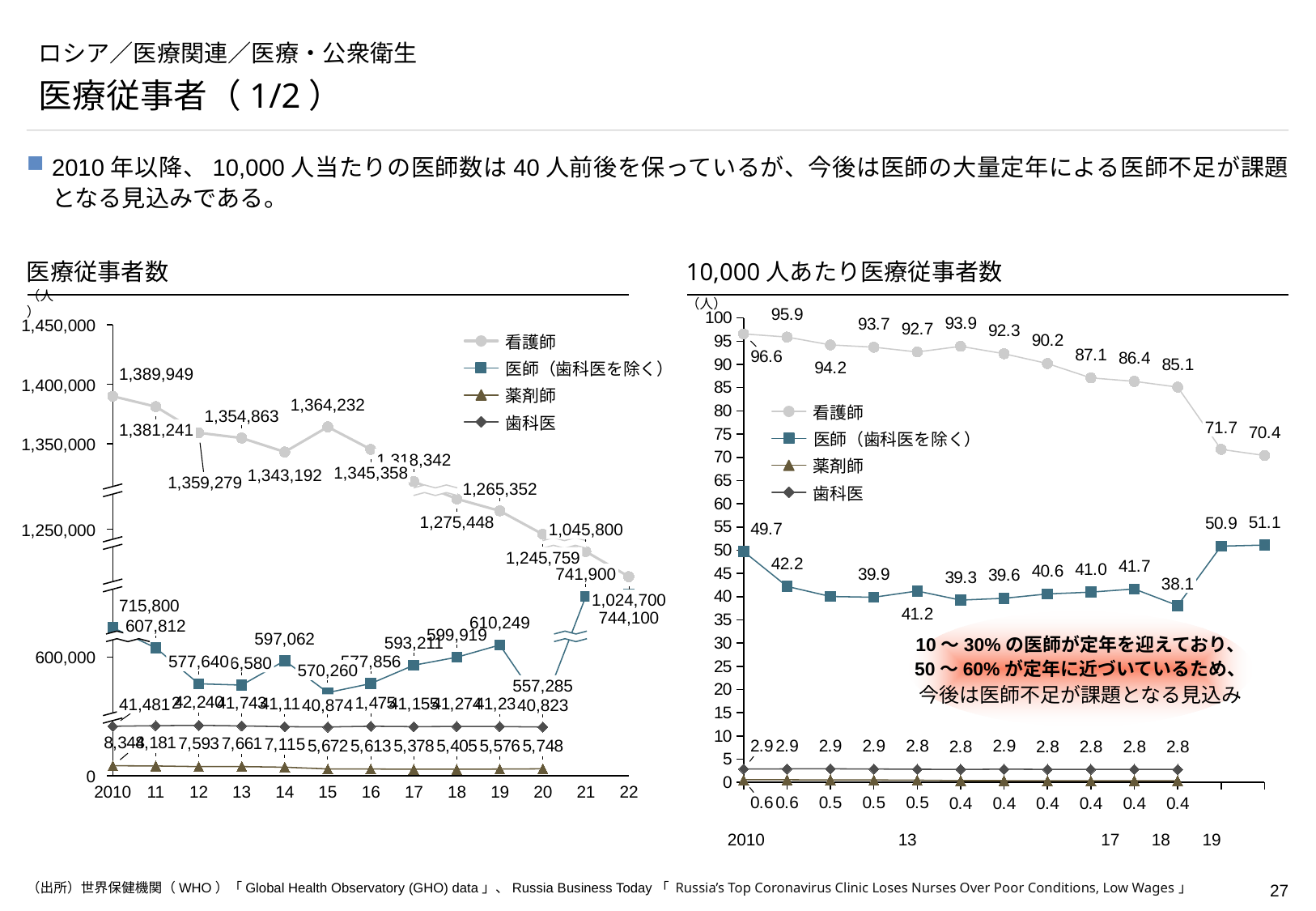
What kind of chart is the 医療従事者数 chart on the left? line chart In the 医療従事者数 chart on the left, what is the difference between the 薬剤師 values for 2010 and 2020? 2,596 In the 10,000人あたり医療従事者数 chart on the right, what is the lowest value shown for 医師（歯科医を除く）? 38.1 In the 医療従事者数 chart on the left, what is the value for 薬剤師 in 2020? 5,748 How many series does the legend of the 医療従事者数 chart on the left list? 4 In the 医療従事者数 chart on the left, what is the value for 看護師 in 2010? 1,389,949 In the 10,000人あたり医療従事者数 chart on the right, what is the value for 看護師 in 2010? 96.6 In the 10,000人あたり医療従事者数 chart on the right, what is the value for 医師（歯科医を除く） in 2010? 49.7 In the 医療従事者数 chart on the left, which is larger in 2010, 看護師 or 薬剤師? 看護師 In the 10,000人あたり医療従事者数 chart on the right, do the 看護師 values generally rise or fall from left to right? fall In the 医療従事者数 chart on the left, what is the value for 薬剤師 in 2010? 8,344 In the 医療従事者数 chart on the left, what is the value for 看護師 in 2015? 1,364,232